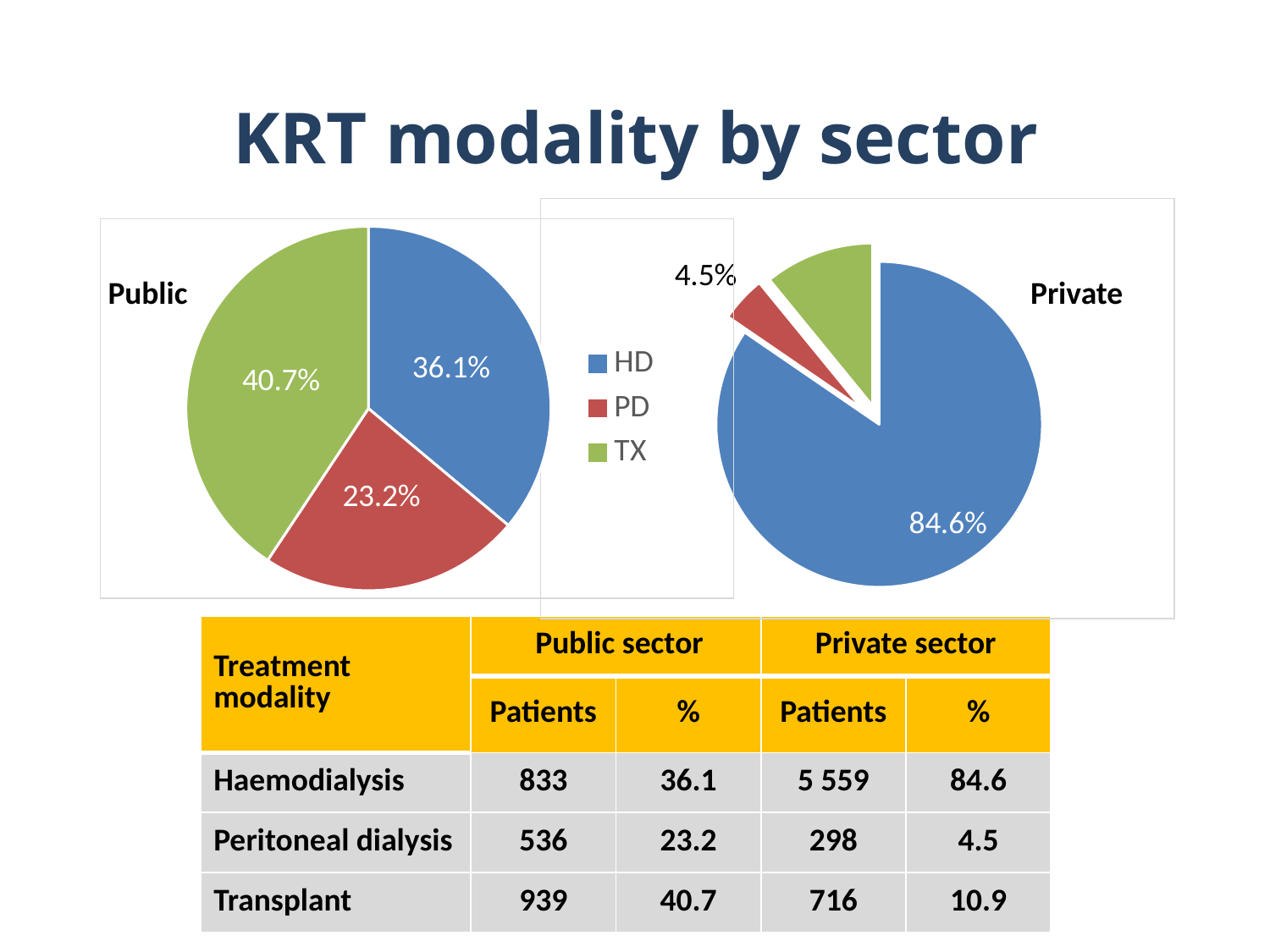
In the Private pie chart, what share does PD have? 4.5% How many entries does the legend between the two pie charts list? 3 In the Private pie chart, which modality has the largest slice? HD In the Public pie chart, what share does PD have? 23.2% In the Public pie chart, which is larger, the HD slice or the PD slice? HD In the Public pie chart, what share does HD have? 36.1% In the Public pie chart, which modality has the largest slice? TX In the Public pie chart, what share does TX have? 40.7% In the Public pie chart, which modality has the smallest slice? PD In the Public pie chart, what is the difference between the TX share and the HD share? 4.6% In the Private pie chart, what share does HD have? 84.6% What kind of chart is the Public chart? pie chart